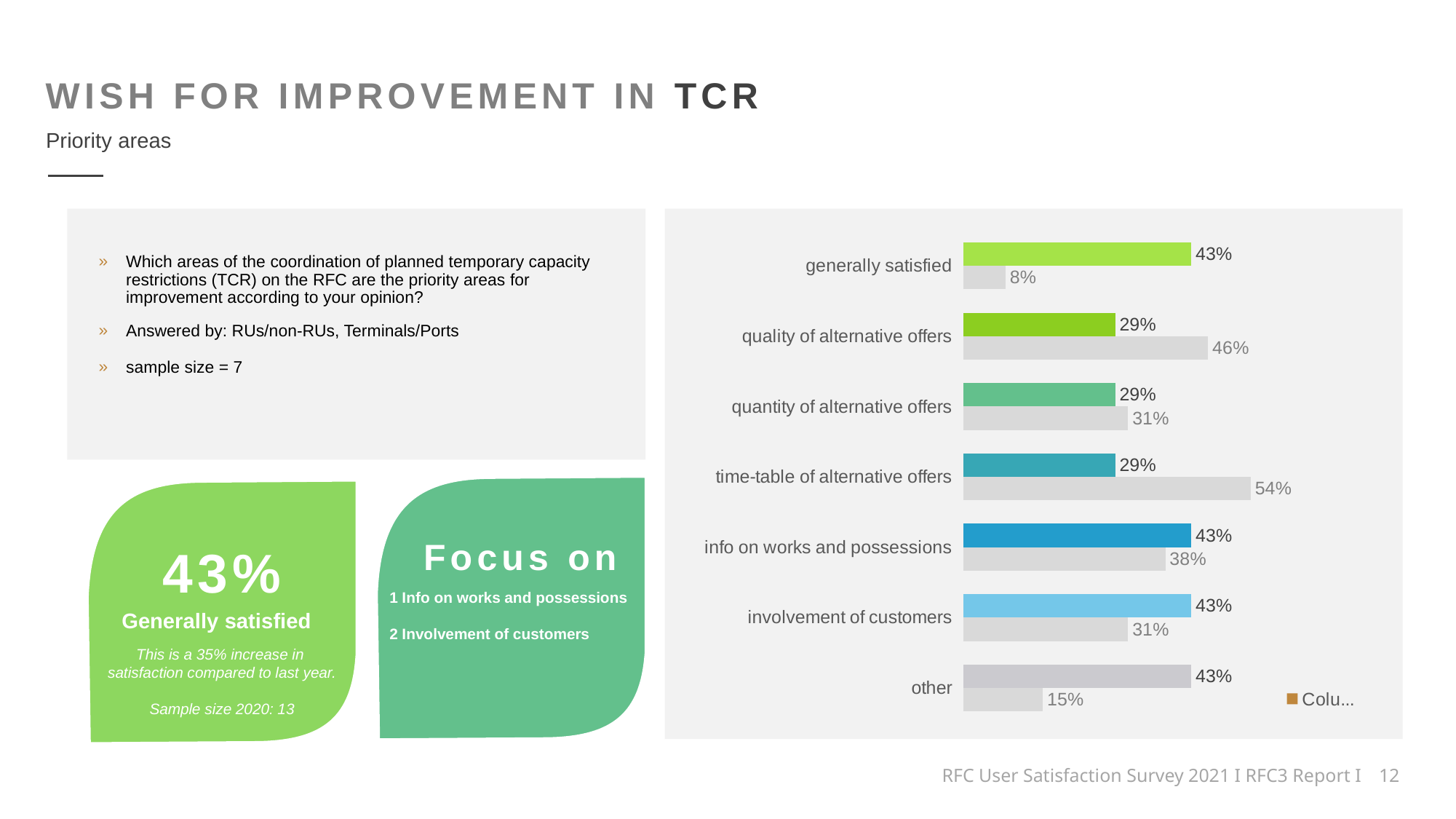
What kind of chart is shown on the right of the slide? bar chart What is the value of the lower (grey) bar for 'involvement of customers'? 31% For 'info on works and possessions', which is larger: the top (coloured) bar or the lower (grey) bar? the top (coloured) bar Which category has the highest value among the lower (grey) bars? time-table of alternative offers How many categories are listed on the chart? 7 What is the value of the top (coloured) bar for 'quality of alternative offers'? 29% Which category has the lowest value among the lower (grey) bars? generally satisfied What is the value of the top (coloured) bar for 'generally satisfied'? 43% What is the difference between the top bar (29%) and the lower bar (54%) for 'time-table of alternative offers'? 25% What is the value of the lower (grey) bar for 'time-table of alternative offers'? 54% What is the difference between the top bar and the lower bar for 'other'? 28% What is the value of the lower (grey) bar for 'generally satisfied'? 8%